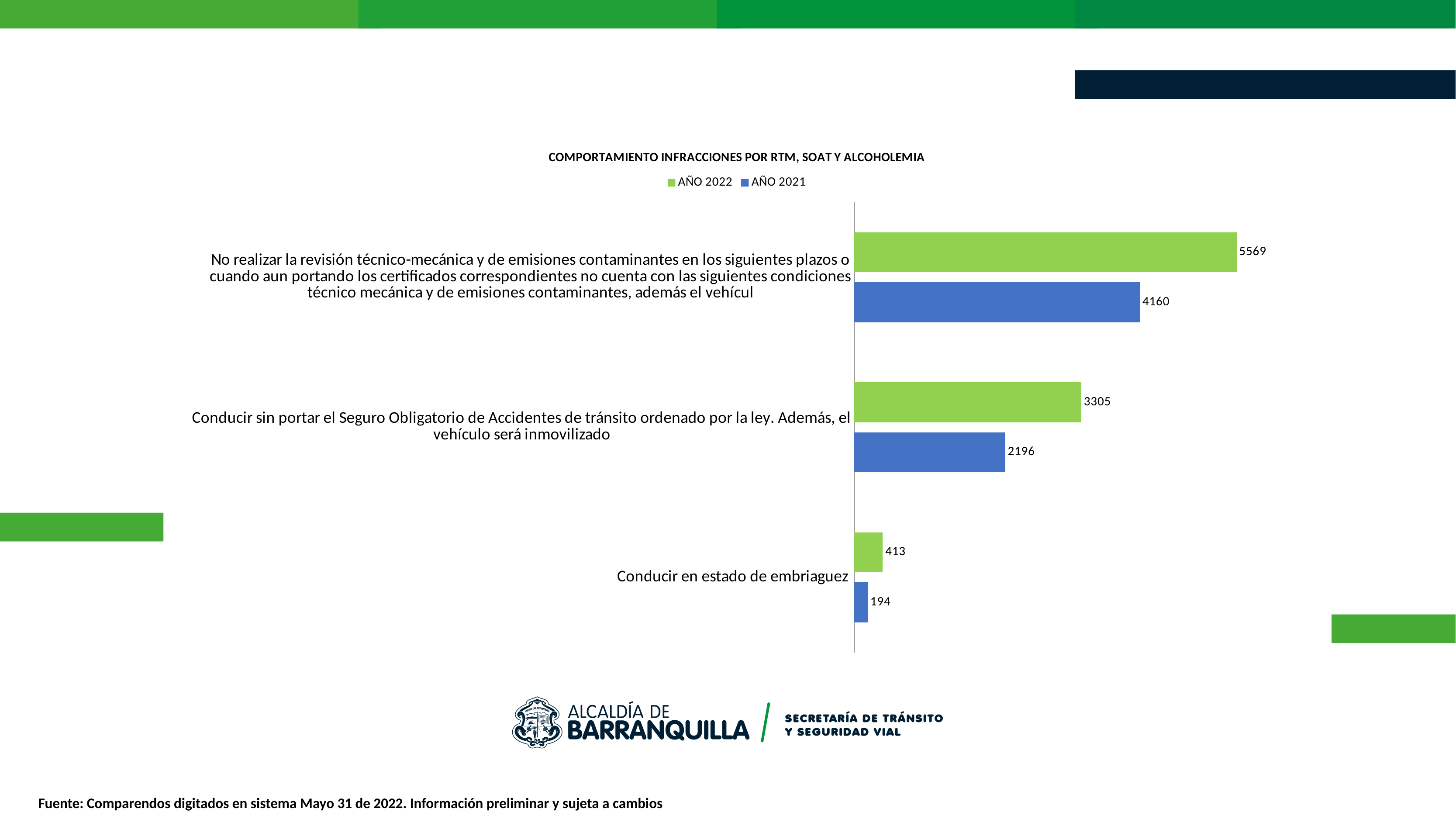
What is the AÑO 2022 value for the category about not performing the técnico-mecánica revision (No realizar la revisión técnico-mecánica...)? 5569 Which category has the lowest AÑO 2021 value? Conducir en estado de embriaguez What type of chart is shown on the slide? Bar chart What is the AÑO 2022 value for 'Conducir en estado de embriaguez'? 413 Which category has the highest AÑO 2022 value? No realizar la revisión técnico-mecánica y de emisiones contaminantes... For 'Conducir en estado de embriaguez', which year has the larger value, AÑO 2022 or AÑO 2021? AÑO 2022 What is the AÑO 2021 value for 'Conducir en estado de embriaguez'? 194 How many series does the legend list? 2 What is the AÑO 2021 value for 'Conducir sin portar el Seguro Obligatorio de Accidentes de tránsito ordenado por la ley'? 2196 What is the difference between the AÑO 2022 and AÑO 2021 values for 'Conducir sin portar el Seguro Obligatorio de Accidentes de tránsito'? 1109 What is the difference between the AÑO 2022 and AÑO 2021 values for the 'No realizar la revisión técnico-mecánica' category? 1409 How many categories are shown in the chart? 3